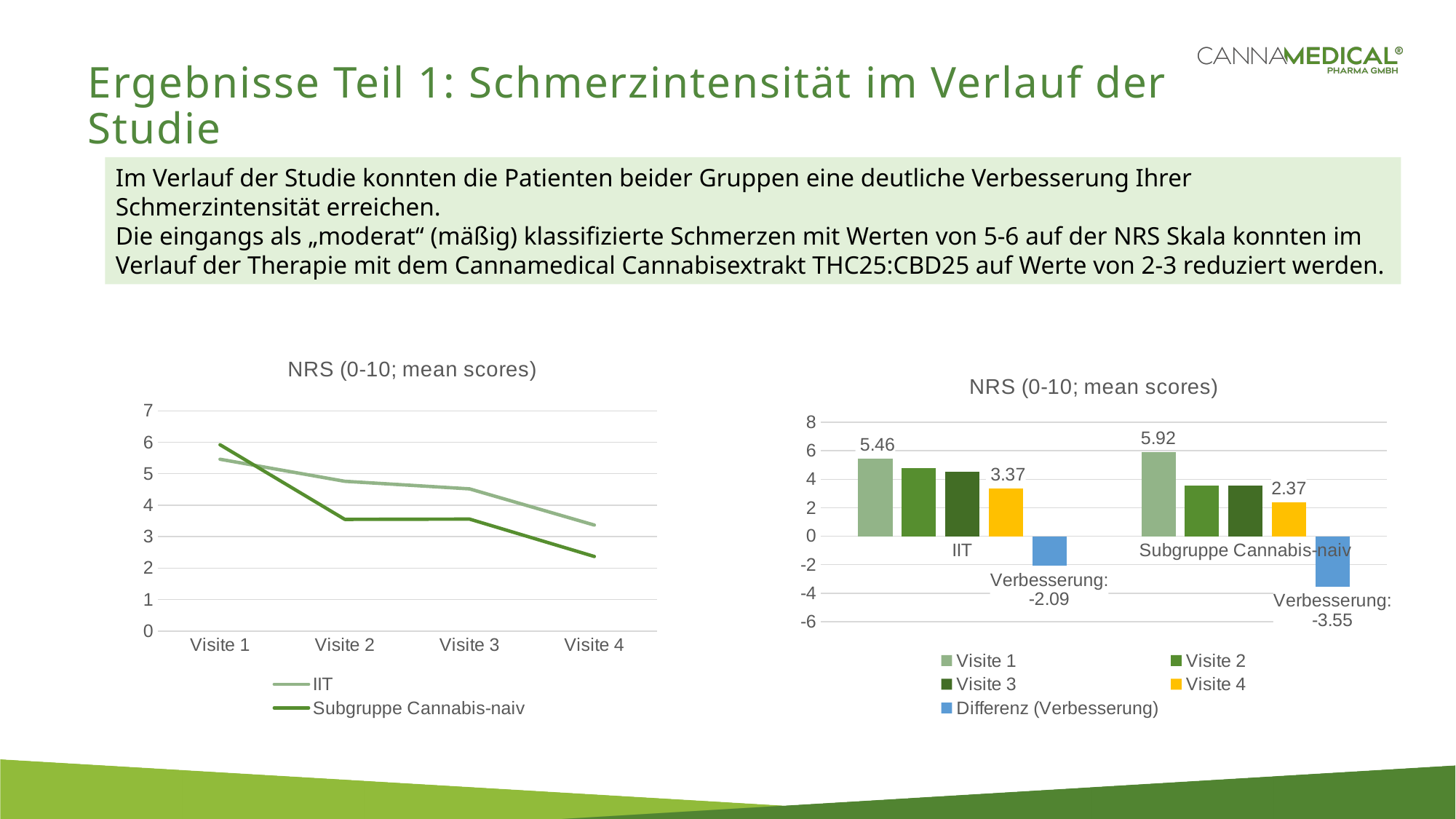
How many series does the legend of the line chart on the left list? 2 In the bar chart on the right, what is the Visite 1 value for IIT? 5.46 In the bar chart on the right, what is the Visite 4 value for Subgruppe Cannabis-naiv? 2.37 In the line chart on the left, is the value for Subgruppe Cannabis-naiv at Visite 4 greater or less than 3? less What type of chart is the chart on the left side of the slide? line chart In the bar chart on the right, what is the Verbesserung (improvement) value shown for IIT? -2.09 How many series does the legend of the bar chart on the right list? 5 In the bar chart on the right, what is the difference between the Visite 4 values of IIT and Subgruppe Cannabis-naiv? 1.00 In the bar chart on the right, which group has the higher Visite 1 value, IIT or Subgruppe Cannabis-naiv? Subgruppe Cannabis-naiv In the line chart on the left, do the values for Subgruppe Cannabis-naiv rise or fall from Visite 1 to Visite 4? fall In the bar chart on the right, what is the Verbesserung (improvement) value shown for Subgruppe Cannabis-naiv? -3.55 What type of chart is the chart on the right side of the slide? bar chart